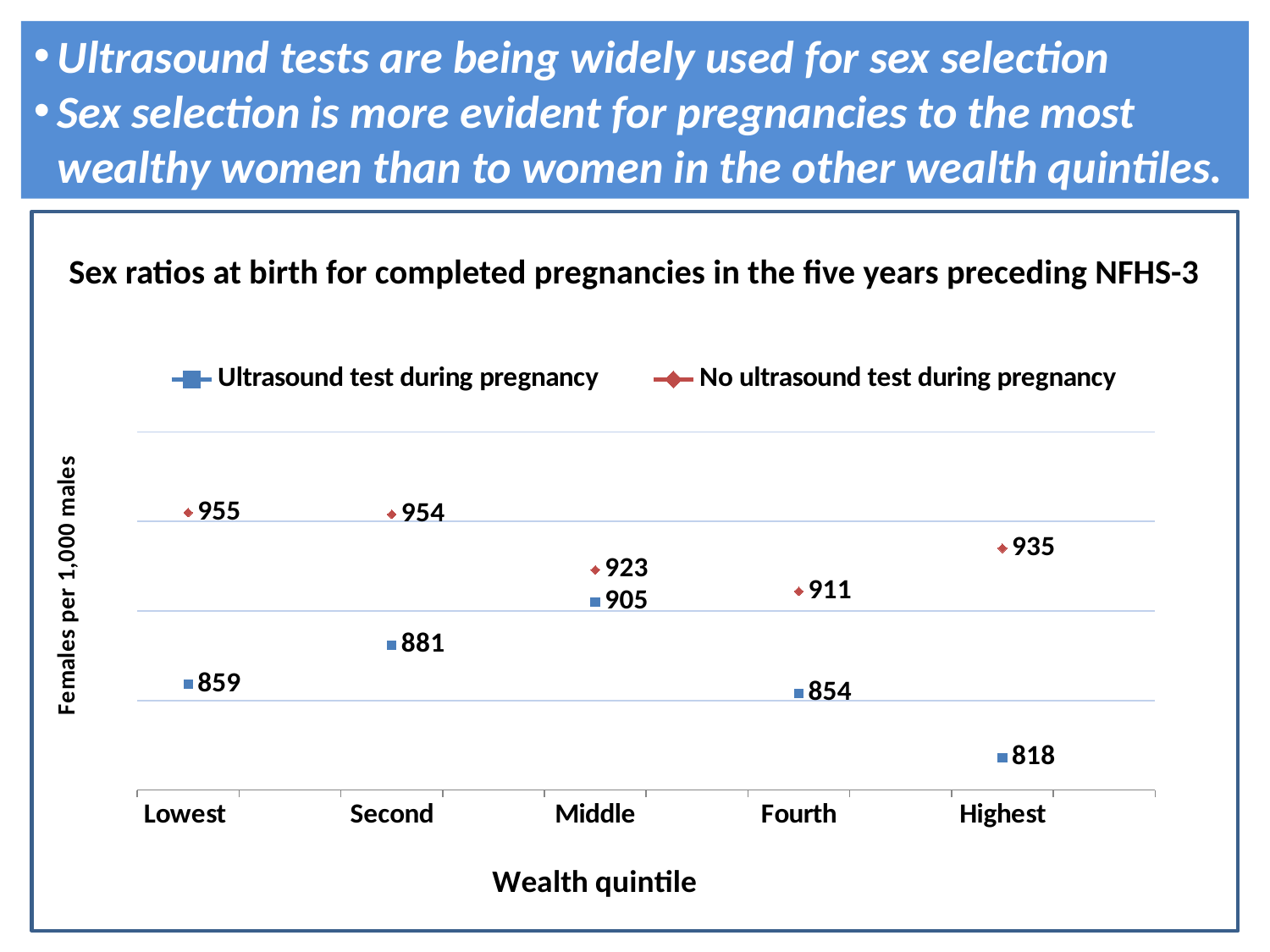
What kind of chart is shown on the slide? Line chart with markers What is the label of the y axis? Females per 1,000 males What is the difference between the 'No ultrasound test' and 'Ultrasound test' values for the Highest wealth quintile? 117 What is the difference between the 'No ultrasound test' and 'Ultrasound test' values for the Middle wealth quintile? 18 Which wealth quintile has the lowest value in the 'Ultrasound test during pregnancy' series? Highest Which wealth quintile has the highest value in the 'No ultrasound test during pregnancy' series? Lowest What is the value for the Middle wealth quintile in the 'Ultrasound test during pregnancy' series? 905 What is the sex ratio at birth for the Lowest wealth quintile among women with no ultrasound test during pregnancy? 955 What is the sex ratio at birth for the Highest wealth quintile among women who had an ultrasound test during pregnancy? 818 How many series does the legend list? 2 How many wealth quintile categories are shown on the x axis? 5 For the Fourth wealth quintile, which series has the larger value: 'Ultrasound test during pregnancy' or 'No ultrasound test during pregnancy'? No ultrasound test during pregnancy